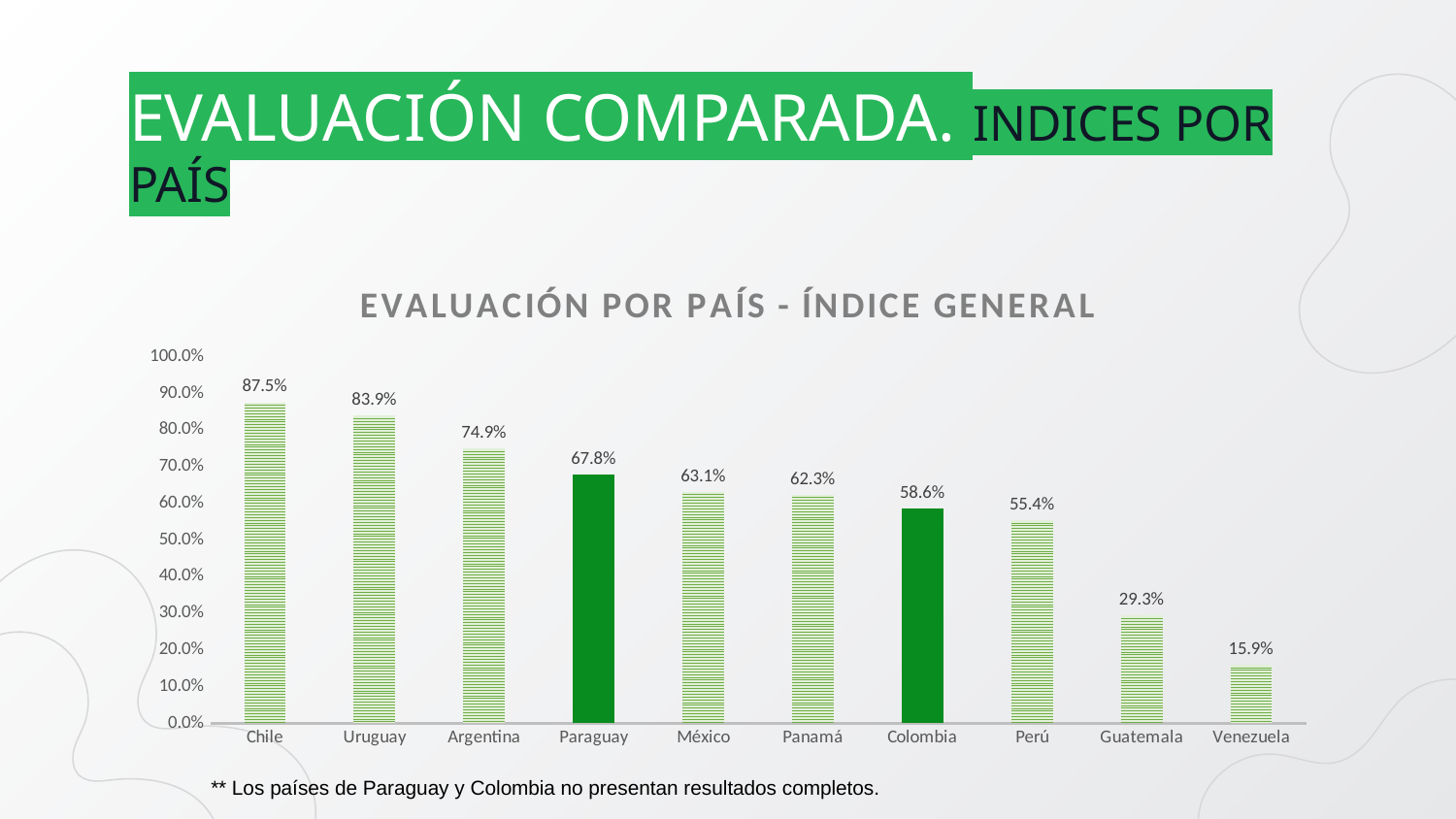
Which country has the lowest value? Venezuela Do the values rise or fall from left to right along the x axis? fall What is the difference between the values for Uruguay and Argentina? 9.0% Which is larger, the value for Paraguay or the value for Perú? Paraguay What is the title of the chart? EVALUACIÓN POR PAÍS - ÍNDICE GENERAL How many countries are shown on the chart? 10 Is the value for México greater or less than 60.0%? greater What kind of chart is shown? bar chart What is the value for Guatemala? 29.3% What is the value for Chile? 87.5% What is the value for Colombia? 58.6% Which country has the highest value? Chile